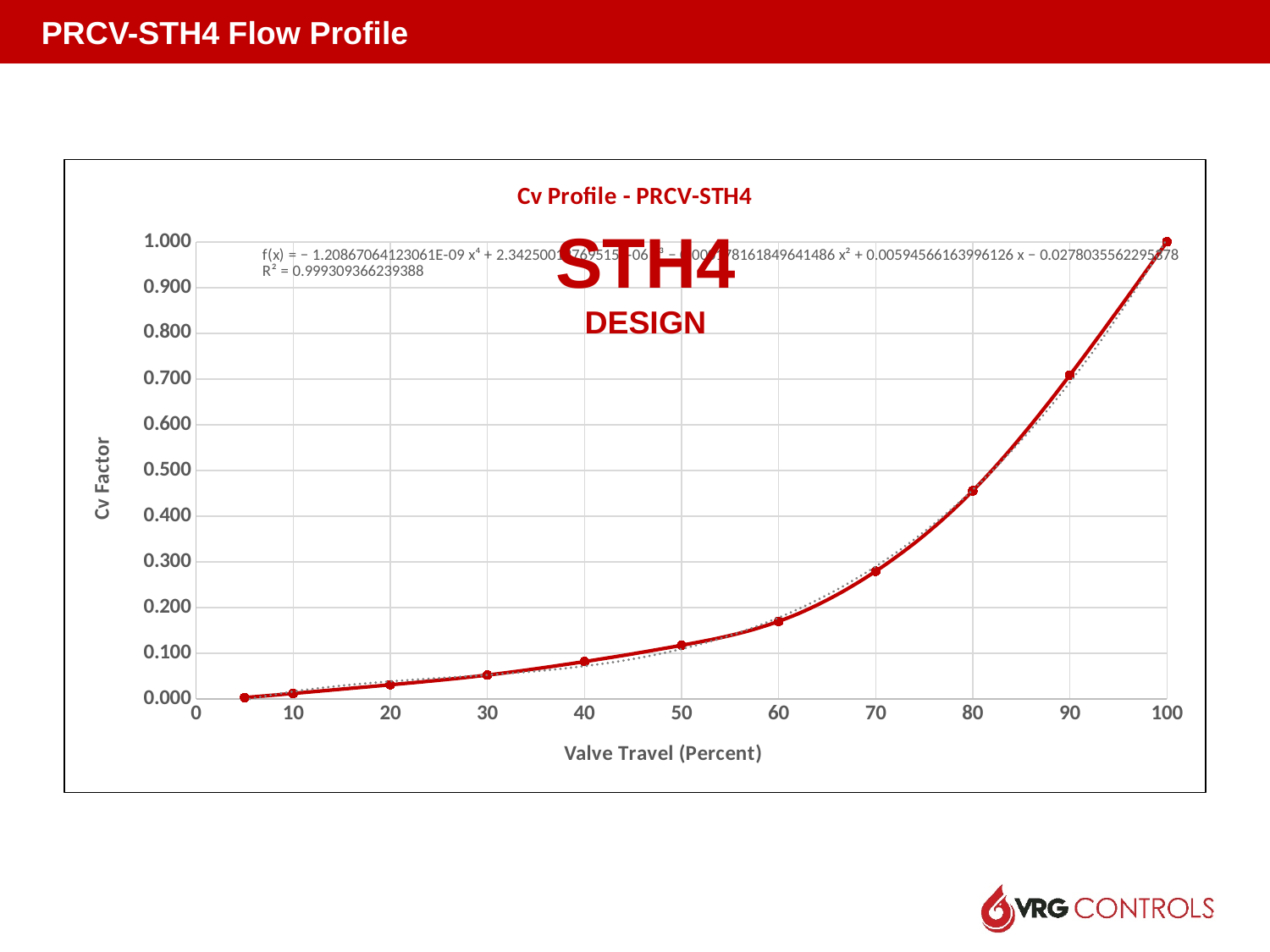
Is the Cv Factor at a Valve Travel of 80 percent greater or less than 0.400? greater Which has the larger Cv Factor, a Valve Travel of 80 percent or 60 percent? 80 What is the Cv Factor at a Valve Travel of 100 percent? 1.000 How many data points are plotted on the curve? 11 Is the Cv Factor at a Valve Travel of 60 percent greater or less than 0.200? less Does the Cv Factor rise or fall as Valve Travel increases? rises Is the Cv Factor at a Valve Travel of 70 percent greater or less than 0.300? less What is the title of the chart? Cv Profile - PRCV-STH4 What is the label of the x axis? Valve Travel (Percent) What kind of chart is shown on the slide? line chart At which Valve Travel value is the Cv Factor highest? 100 At which Valve Travel value is the Cv Factor lowest? 5